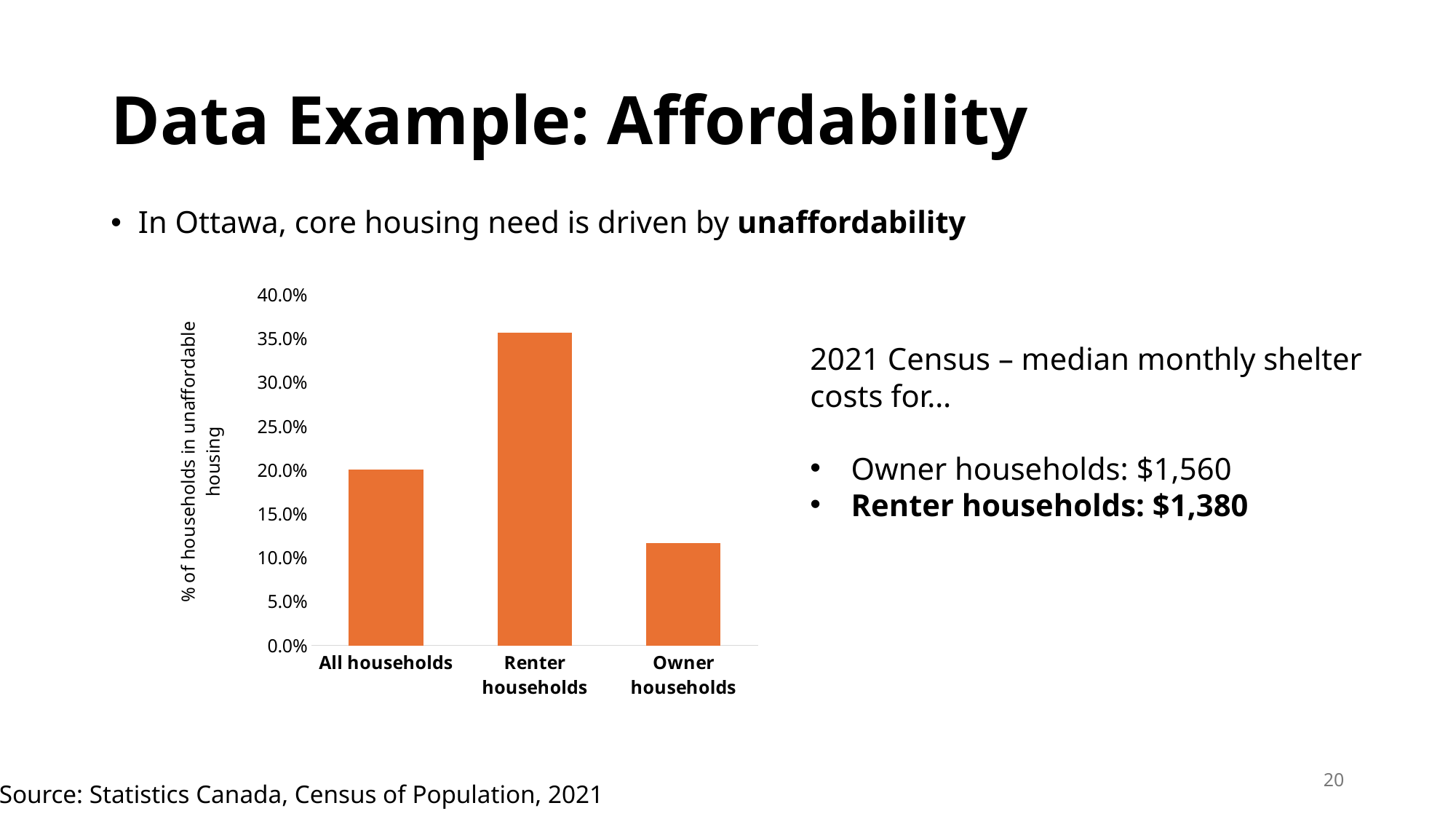
Which category has the lowest percentage of households in unaffordable housing? Owner households Is the value for All households greater or less than 25.0%? less Which is larger, the value for All households or the value for Owner households? All households Is the value for Renter households greater or less than 30.0%? greater Which is larger, the value for Renter households or the value for Owner households? Renter households Which category has the highest percentage of households in unaffordable housing? Renter households What kind of chart is shown on the slide? bar chart Is the value for Renter households greater or less than 40.0%? less What colour are the bars in the chart? orange How many categories are plotted in the bar chart? 3 What is the label on the vertical axis of the chart? % of households in unaffordable housing